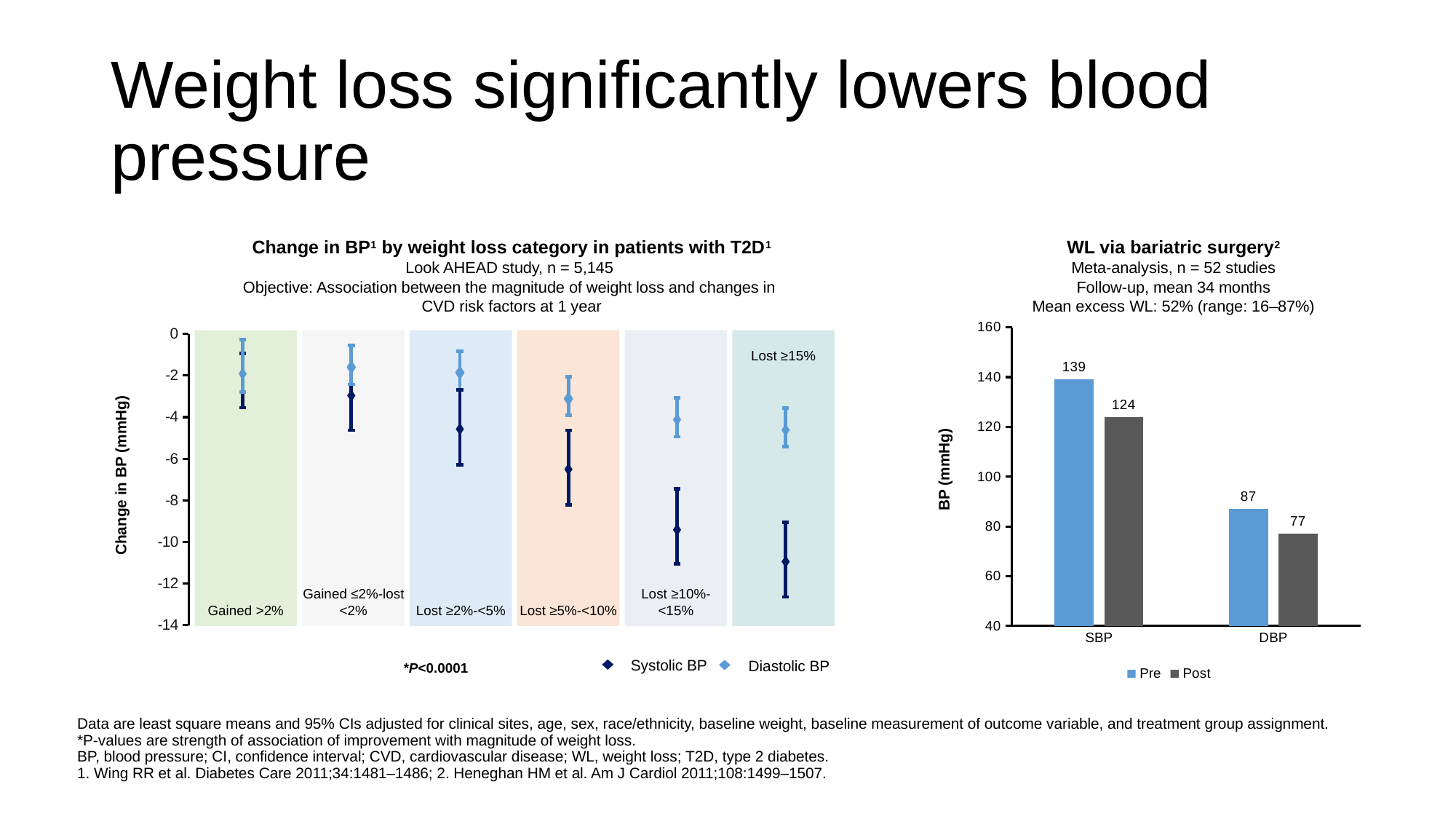
How many series does the legend of the 'WL via bariatric surgery' chart list? 2 In the 'WL via bariatric surgery' chart, what is the Post value for DBP? 77 In the 'WL via bariatric surgery' chart, what is the difference between the Pre and Post values for DBP? 10 How many series does the legend of the 'Change in BP by weight loss category' chart list? 2 In the 'WL via bariatric surgery' chart, which is larger, the Pre value for DBP or the Post value for DBP? Pre How many weight loss categories are shown in the 'Change in BP by weight loss category' chart? 6 In the 'WL via bariatric surgery' chart, what is the difference between the Pre and Post values for SBP? 15 In the 'WL via bariatric surgery' chart, what is the Pre value for SBP? 139 In the 'Change in BP by weight loss category' chart, is the Systolic BP value for 'Lost ≥15%' greater or less than -10? less What kind of chart is the 'WL via bariatric surgery' chart? Bar chart In the 'Change in BP by weight loss category' chart, does the Systolic BP change rise or fall as the categories move from 'Gained >2%' to 'Lost ≥15%'? Fall In the 'Change in BP by weight loss category' chart, which weight loss category has the lowest Systolic BP change? Lost ≥15%